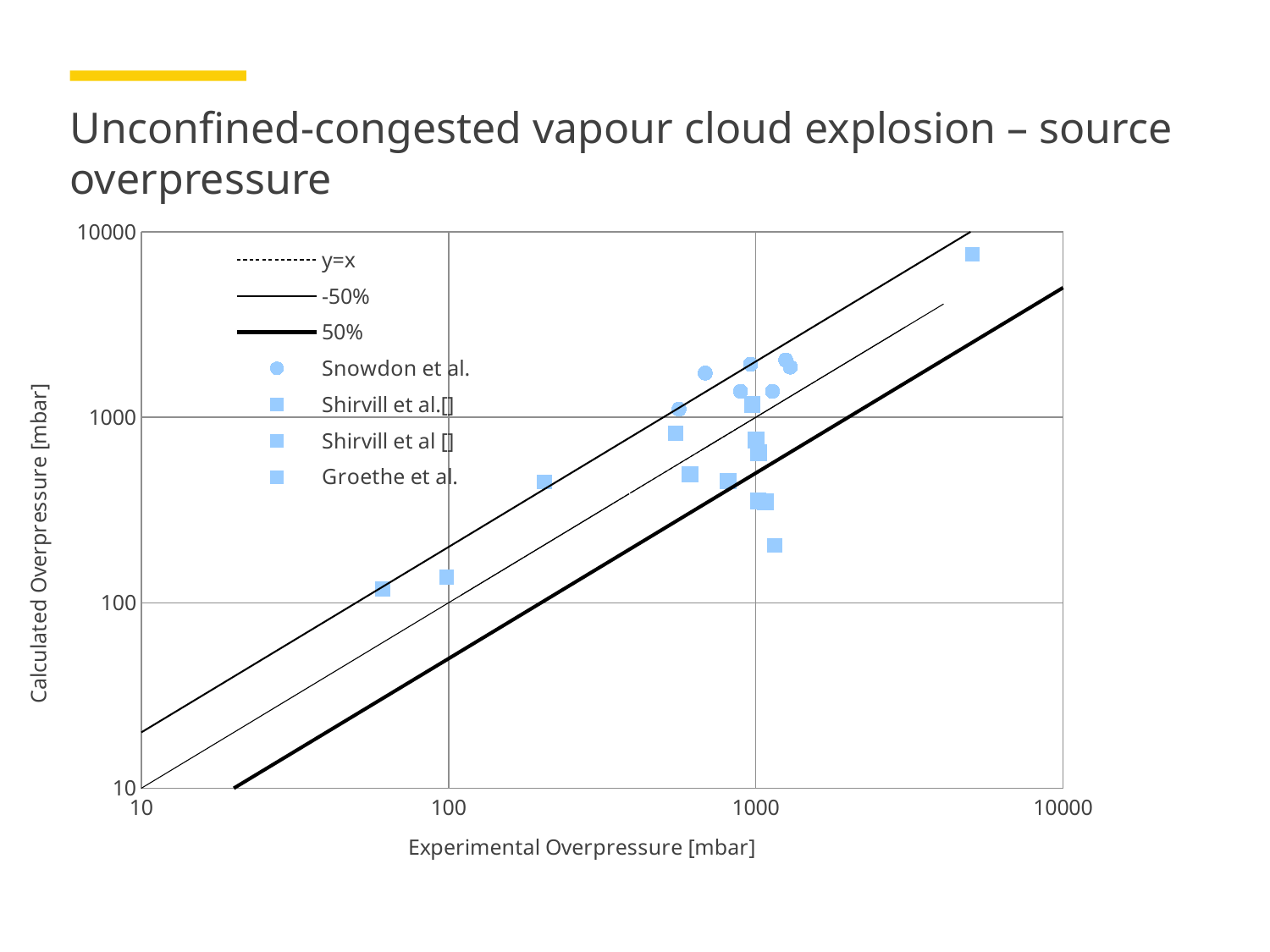
How many entries does the chart's legend list? 7 Is the highest value shown on the x axis greater or less than 1000? greater What kind of chart is shown on the slide? scatter chart Do the calculated overpressures generally rise or fall as experimental overpressure increases along the x axis? rise Is the calculated overpressure of the highest plotted point greater or less than 1000? greater Is the calculated overpressure of the lowest point plotted near an experimental overpressure of 1000 greater or less than 100? greater What is the title of the x axis of the chart? Experimental Overpressure [mbar] What is the title of the y axis of the chart? Calculated Overpressure [mbar]